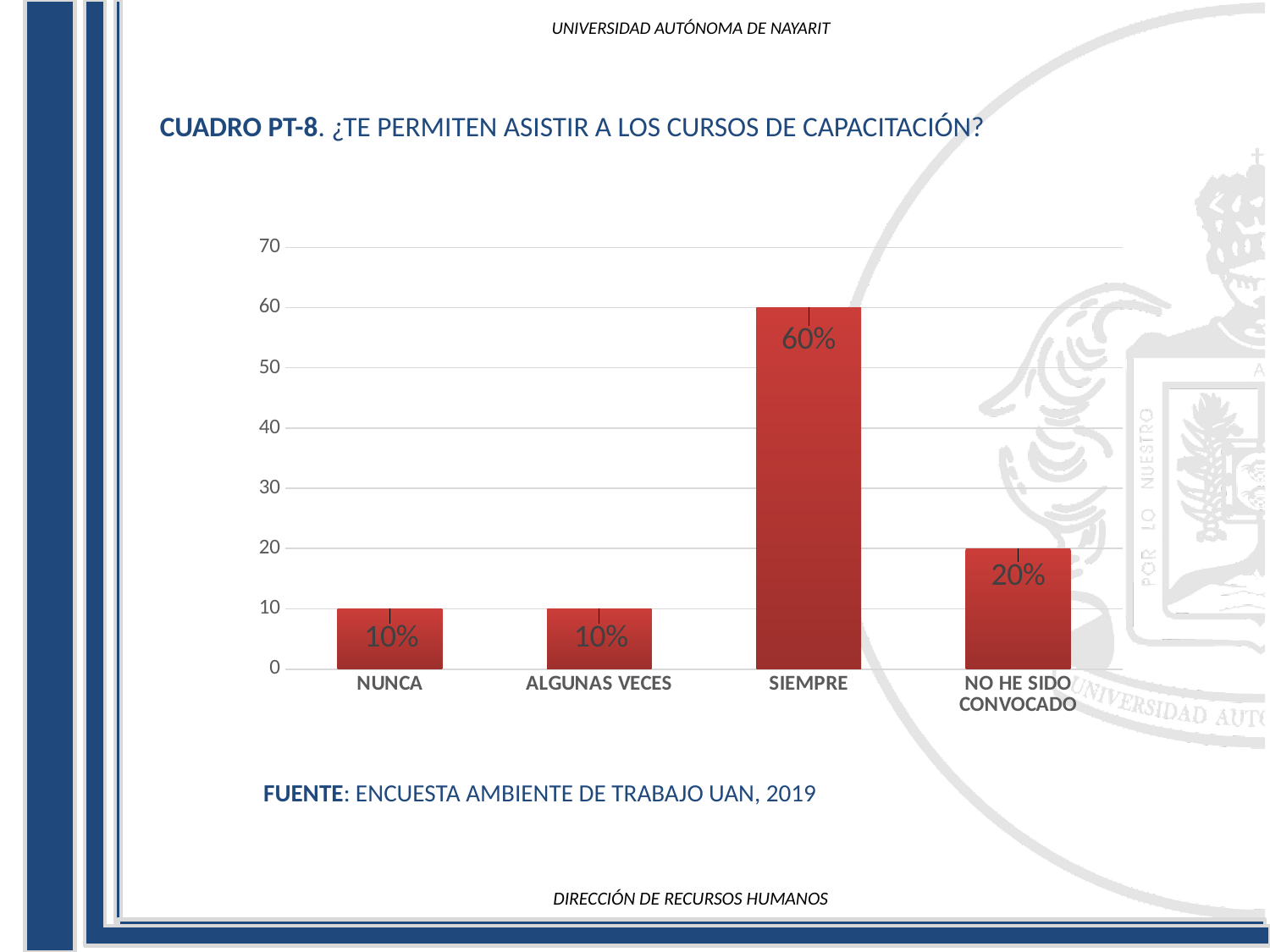
What kind of chart is shown on the slide? bar chart What is the value for SIEMPRE? 60% What is the source cited below the chart? ENCUESTA AMBIENTE DE TRABAJO UAN, 2019 Is the value for SIEMPRE greater or less than 50? greater What is the value for ALGUNAS VECES? 10% What is the difference between the values for SIEMPRE and NO HE SIDO CONVOCADO? 40% How many categories are shown on the x axis? 4 What is the value for NO HE SIDO CONVOCADO? 20% Which is larger, the value for SIEMPRE or the value for NO HE SIDO CONVOCADO? SIEMPRE What is the value for NUNCA? 10% What is the difference between the values for NO HE SIDO CONVOCADO and NUNCA? 10% Which category has the highest value? SIEMPRE